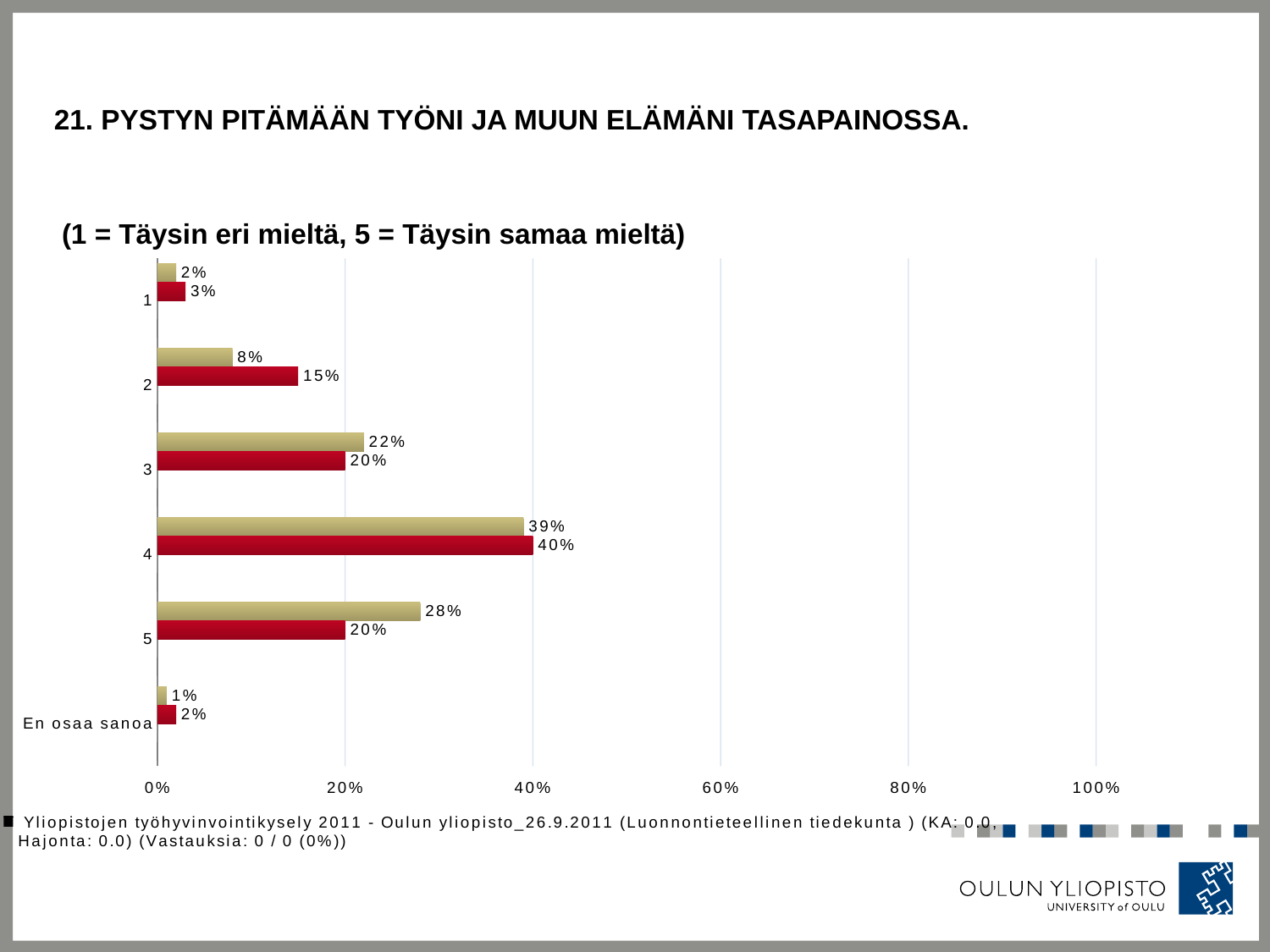
What is the highest value shown on the horizontal axis? 100% What is the difference between the red bar for category 2 and the tan bar for category 2? 7% Which category has the lowest value for the red series? En osaa sanoa For category 3, which is larger: the tan bar or the red bar? the tan bar What is the value of the tan bar for category 5? 28% What is the difference between the tan and red bars for category 5? 8% What type of chart is shown on the slide? bar chart What is the value of the red bar for category 2? 15% What is the value of the tan bar for 'En osaa sanoa'? 1% Which category has the highest value for the tan series? 4 What is the value of the red bar for category 4? 40% How many categories are shown on the vertical axis? 6